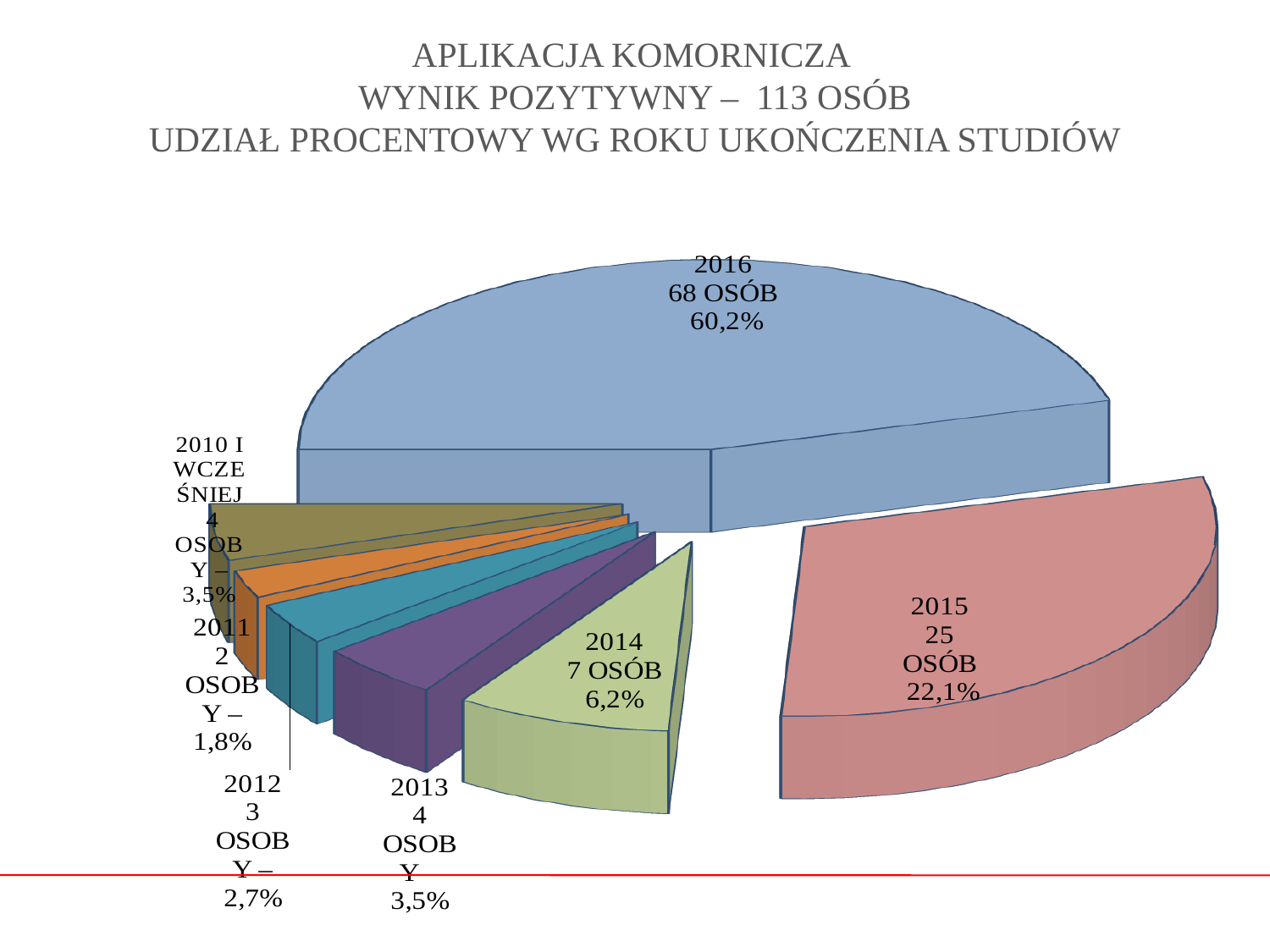
What percentage share does the '2010 i wcześniej' slice have? 3,5% What percentage share does the 2012 slice have? 2,7% How many people are in the 2013 slice? 4 How many people (osób) are in the 2015 slice? 25 What percentage share does the 2016 slice have? 60,2% Which year has the smallest slice of the pie? 2011 What kind of chart is shown on the slide? pie chart How many slices does the pie chart have? 7 What is the difference in number of people between the 2016 and 2015 slices? 43 Which slice is larger, 2014 or 2013? 2014 Which year has the largest slice of the pie? 2016